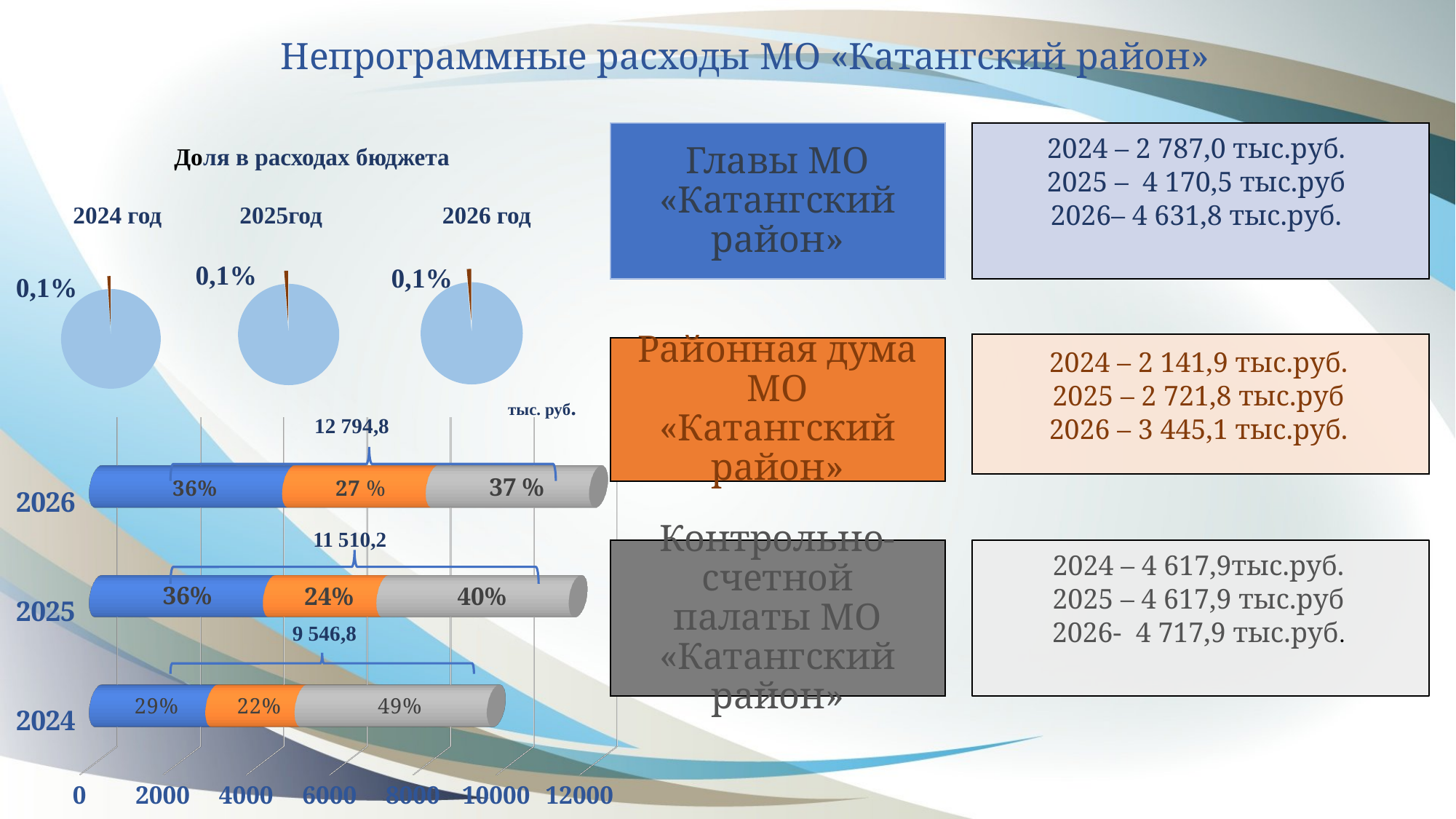
In the stacked bar chart at the bottom left, what percentage is shown on the blue segment of the 2025 bar? 36% In the stacked bar chart at the bottom left, do the labelled totals rise or fall from 2024 to 2026? rise What kind of chart is shown at the bottom left of the slide? bar chart In the stacked bar chart at the bottom left, what percentage is shown on the grey segment of the 2024 bar? 49% In the stacked bar chart at the bottom left, which year has the lowest labelled total? 2024 In the stacked bar chart at the bottom left, which year has the highest labelled total? 2026 In the pie chart labelled '2025год' under 'Доля в расходах бюджета', what share is labelled? 0,1% In the stacked bar chart at the bottom left, what total value is labelled above the 2026 bar? 12 794,8 In the stacked bar chart at the bottom left, what percentage is shown on the orange segment of the 2026 bar? 27 % In the stacked bar chart at the bottom left, is the grey segment percentage larger for 2024 or for 2026? 2024 In the stacked bar chart at the bottom left, what is the difference between the 2026 total and the 2025 total? 1 284,6 In the stacked bar chart at the bottom left, what total value is labelled above the 2024 bar? 9 546,8